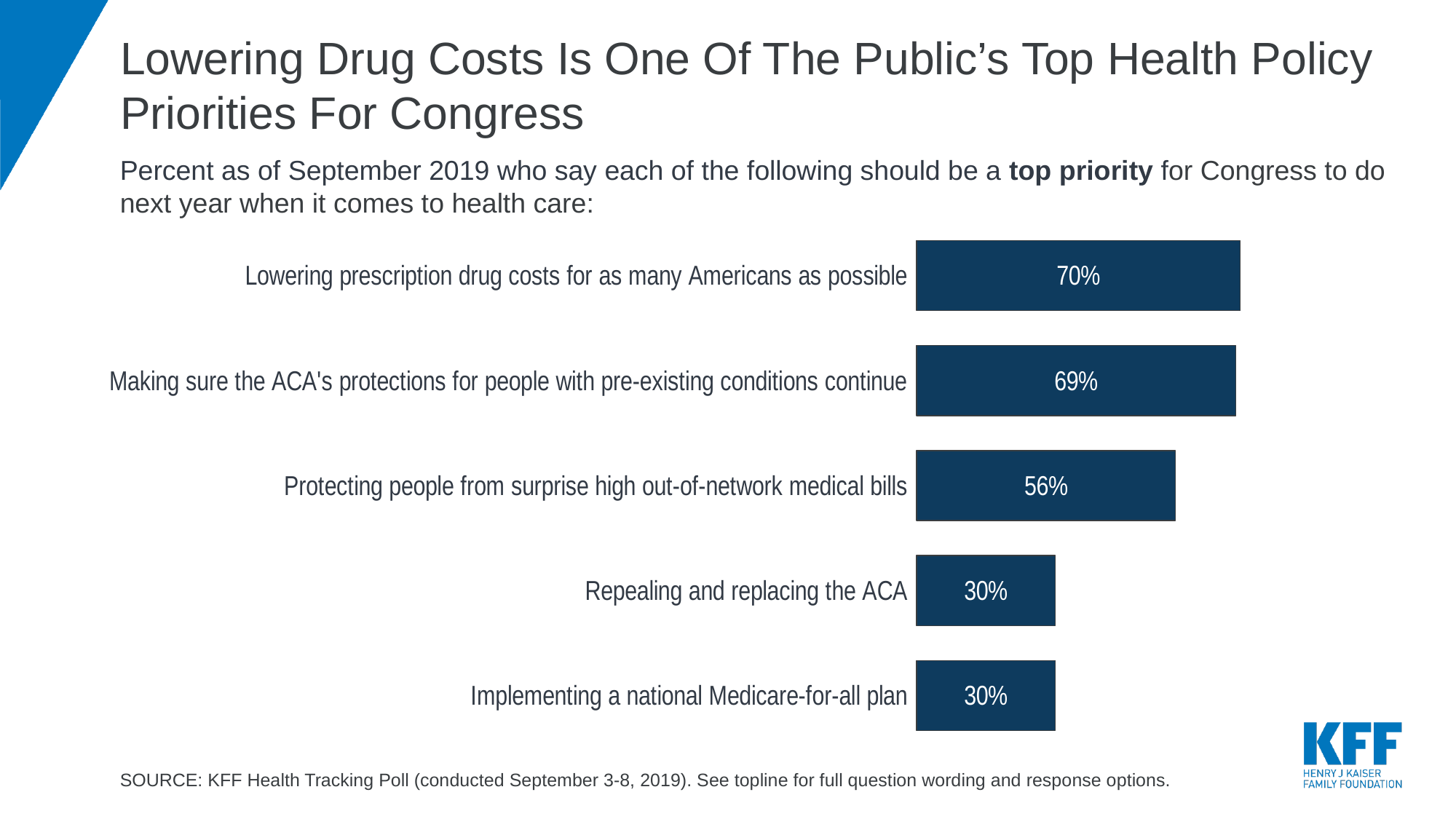
What percent say protecting people from surprise high out-of-network medical bills should be a top priority? 56% Which has a higher percent: protecting people from surprise high out-of-network medical bills or implementing a national Medicare-for-all plan? Protecting people from surprise high out-of-network medical bills What percent say making sure the ACA's protections for people with pre-existing conditions continue should be a top priority? 69% What is the difference in percentage points between lowering prescription drug costs and protecting people from surprise high out-of-network medical bills? 14 percentage points How many items are shown in the chart? 5 What percent say lowering prescription drug costs for as many Americans as possible should be a top priority? 70% What percent say repealing and replacing the ACA should be a top priority? 30% Which item has the highest percent saying it should be a top priority? Lowering prescription drug costs for as many Americans as possible What is the source of the data shown in the chart? KFF Health Tracking Poll (conducted September 3-8, 2019) What percent say implementing a national Medicare-for-all plan should be a top priority? 30% What is the difference in percentage points between making sure the ACA's pre-existing condition protections continue and repealing and replacing the ACA? 39 percentage points What kind of chart is shown on the slide? Bar chart